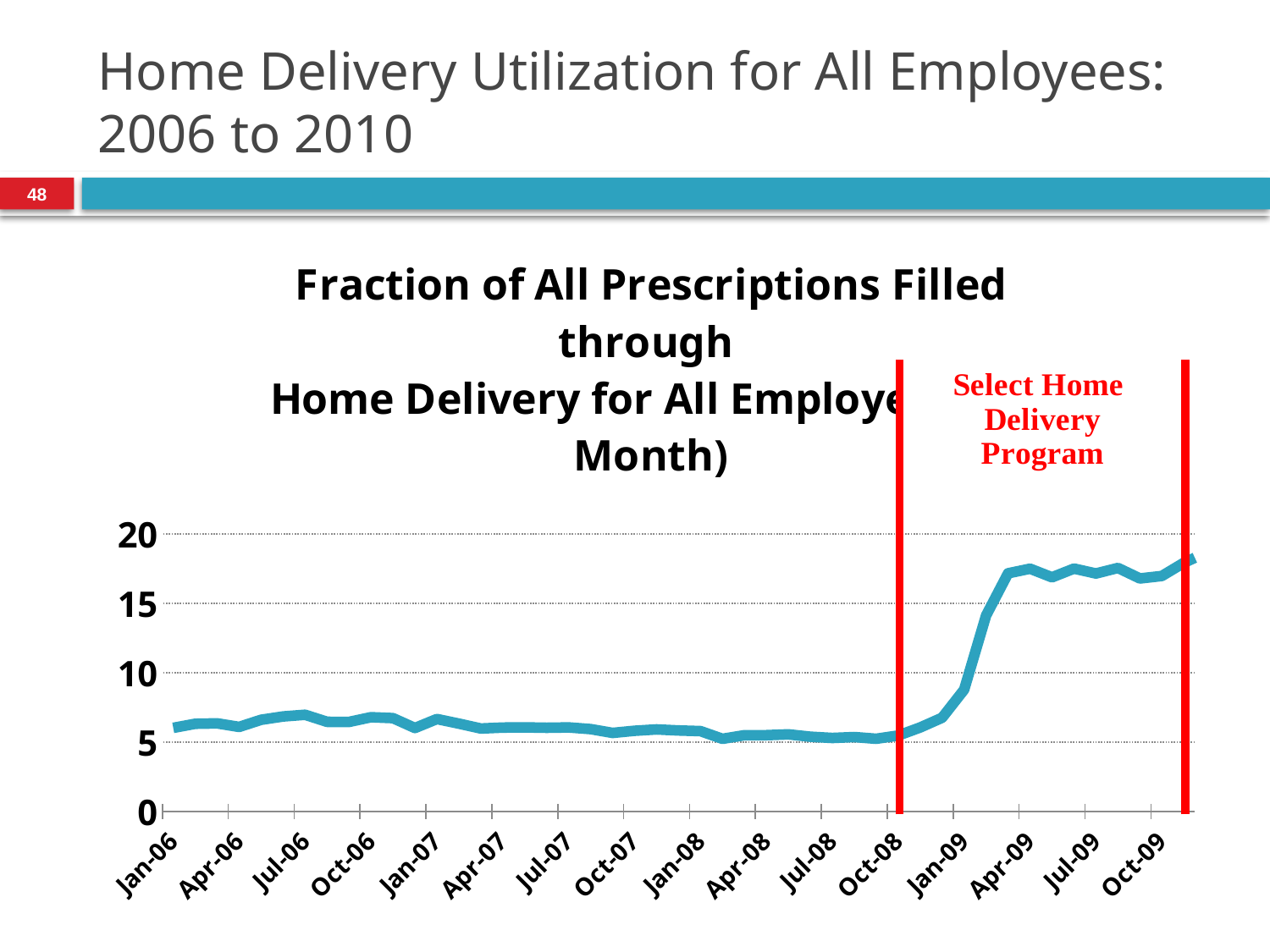
Is the value for Oct-08 greater or less than 10? less Does the line rise or fall between Oct-08 and Apr-09? rise Is the value for Apr-09 greater or less than 15? greater Is the value for Oct-09 greater or less than 15? greater How many month labels are shown on the x axis? 16 What is the highest value shown on the y axis? 20 What kind of chart is shown on the slide? line chart Which is larger, the value for Jan-07 or the value for Jul-09? Jul-09 What text is written in red between the two vertical red lines? Select Home Delivery Program Which is larger, the value for Apr-09 or the value for Apr-08? Apr-09